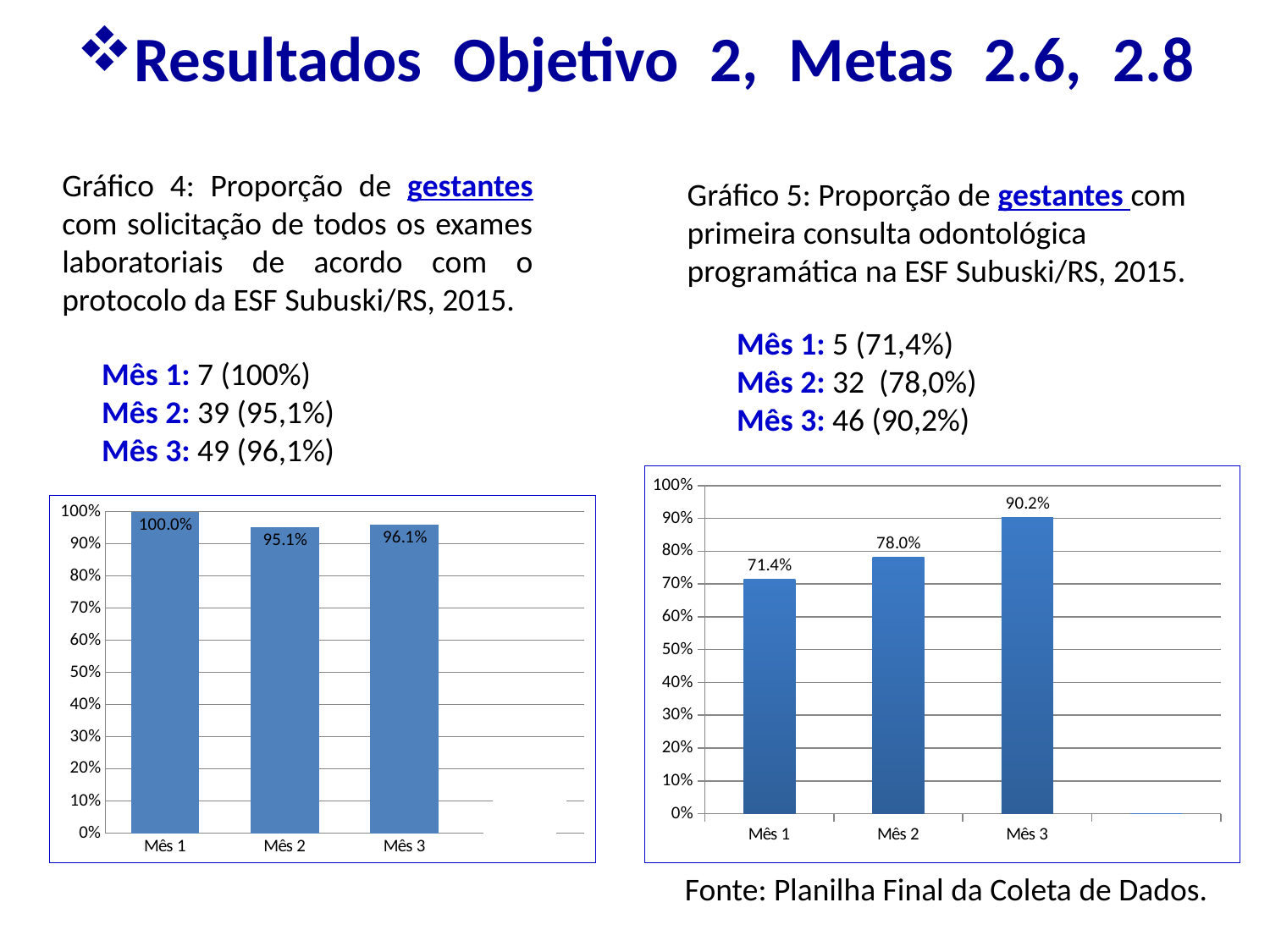
In the right chart (Gráfico 5), is the value for Mês 2 greater or less than 80%? less In the right chart (Gráfico 5), do the values rise or fall from Mês 1 to Mês 3? rise In the right chart (Gráfico 5), what is the difference between the values for Mês 3 and Mês 2? 12.2% In the left chart (Gráfico 4), what is the value for Mês 1? 100.0% In the left chart (Gráfico 4), which month has the lowest value? Mês 2 In the left chart (Gráfico 4), what is the value for Mês 2? 95.1% In the left chart (Gráfico 4), how many bars are plotted? 3 In the left chart (Gráfico 4), what is the difference between the values for Mês 1 and Mês 3? 3.9% In the right chart (Gráfico 5), which month has the highest value? Mês 3 What kind of chart is the right chart (Gráfico 5)? bar chart In the right chart (Gráfico 5), what is the value for Mês 3? 90.2% In the right chart (Gráfico 5), what is the value for Mês 1? 71.4%